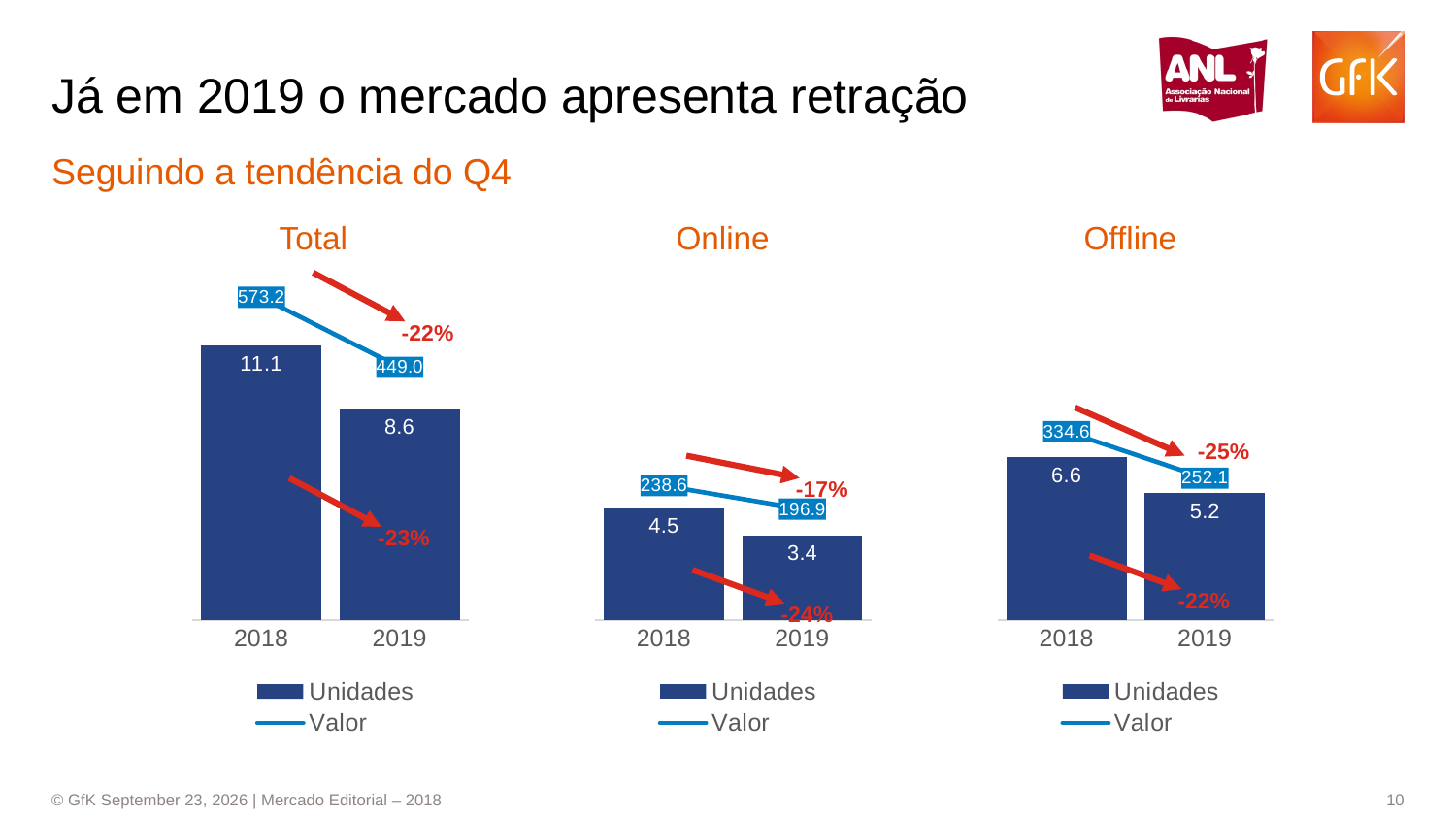
In the Offline chart, what is the difference in Unidades between 2018 and 2019? 1.4 What type of chart is used for the Unidades series in the Offline chart? bar chart In the Online chart, what is the Unidades value for 2019? 3.4 In the Total chart, what is the Unidades value for 2018? 11.1 How many categories are shown on the x axis of the Online chart? 2 In the Offline chart, what is the Valor value for 2019? 252.1 How many series does the legend of the Total chart list? 2 In the Online chart, which year has the higher Unidades value? 2018 In the Total chart, what is the Valor value for 2019? 449.0 In the Total chart, what is the difference in Valor between 2018 and 2019? 124.2 In the Online chart, what is the Valor value for 2018? 238.6 In the Offline chart, does the Valor line rise or fall from 2018 to 2019? fall